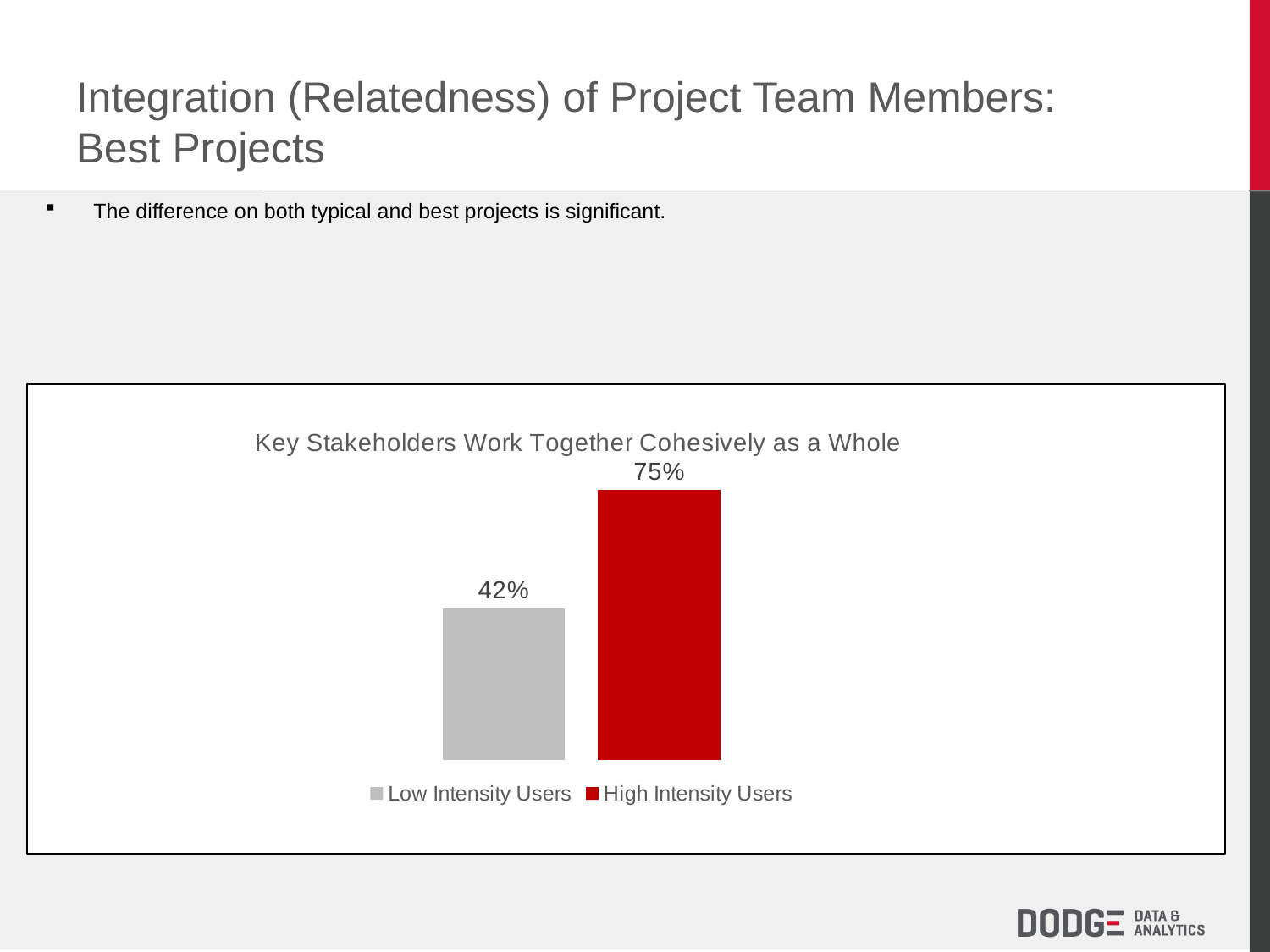
Which series has the lower value? Low Intensity Users What is the difference between the High Intensity Users and Low Intensity Users values? 33% What is the value for Low Intensity Users? 42% Which series has the higher value? High Intensity Users What is the title of the chart? Key Stakeholders Work Together Cohesively as a Whole How many bars are plotted in the chart? 2 What kind of chart is shown? bar chart What colour is the bar for High Intensity Users? red Is the value for Low Intensity Users larger or smaller than the value for High Intensity Users? smaller How many series does the legend list? 2 What is the value for High Intensity Users? 75%